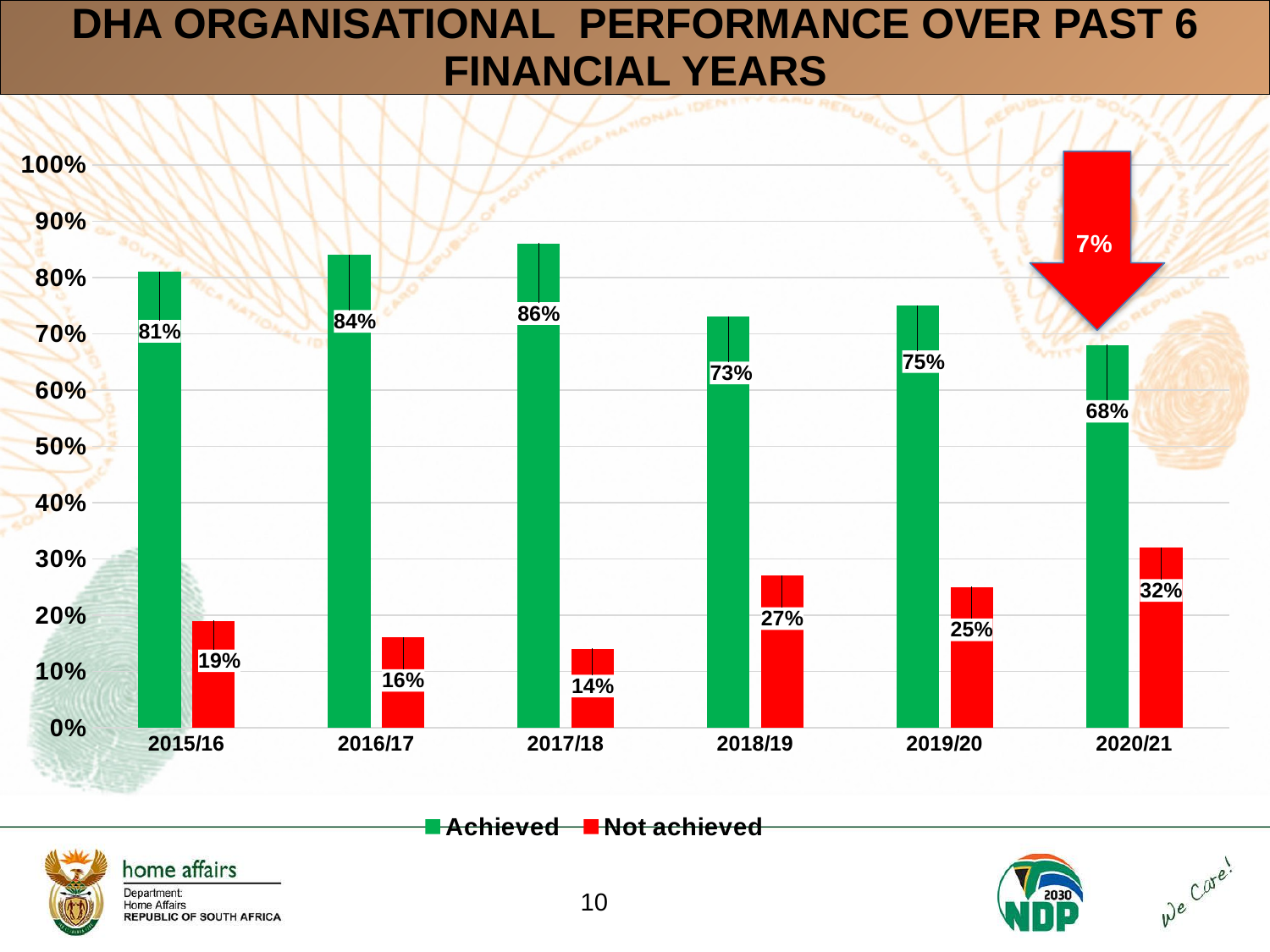
What is the 'Not achieved' value for 2020/21? 32% What percentage was achieved in 2017/18? 86% Which financial year has the highest 'Achieved' percentage? 2017/18 How many series does the legend list? 2 Which financial year has the lowest 'Not achieved' percentage? 2017/18 What percentage was achieved in 2019/20? 75% How many financial years are shown on the x axis? 6 Which is larger: the 'Not achieved' value for 2018/19 or for 2019/20? 2018/19 What colour represents the 'Not achieved' series? Red Which financial year has the lowest 'Achieved' percentage? 2020/21 What kind of chart is shown on the slide? Bar chart What is the difference between the 'Achieved' values for 2019/20 and 2020/21? 7%